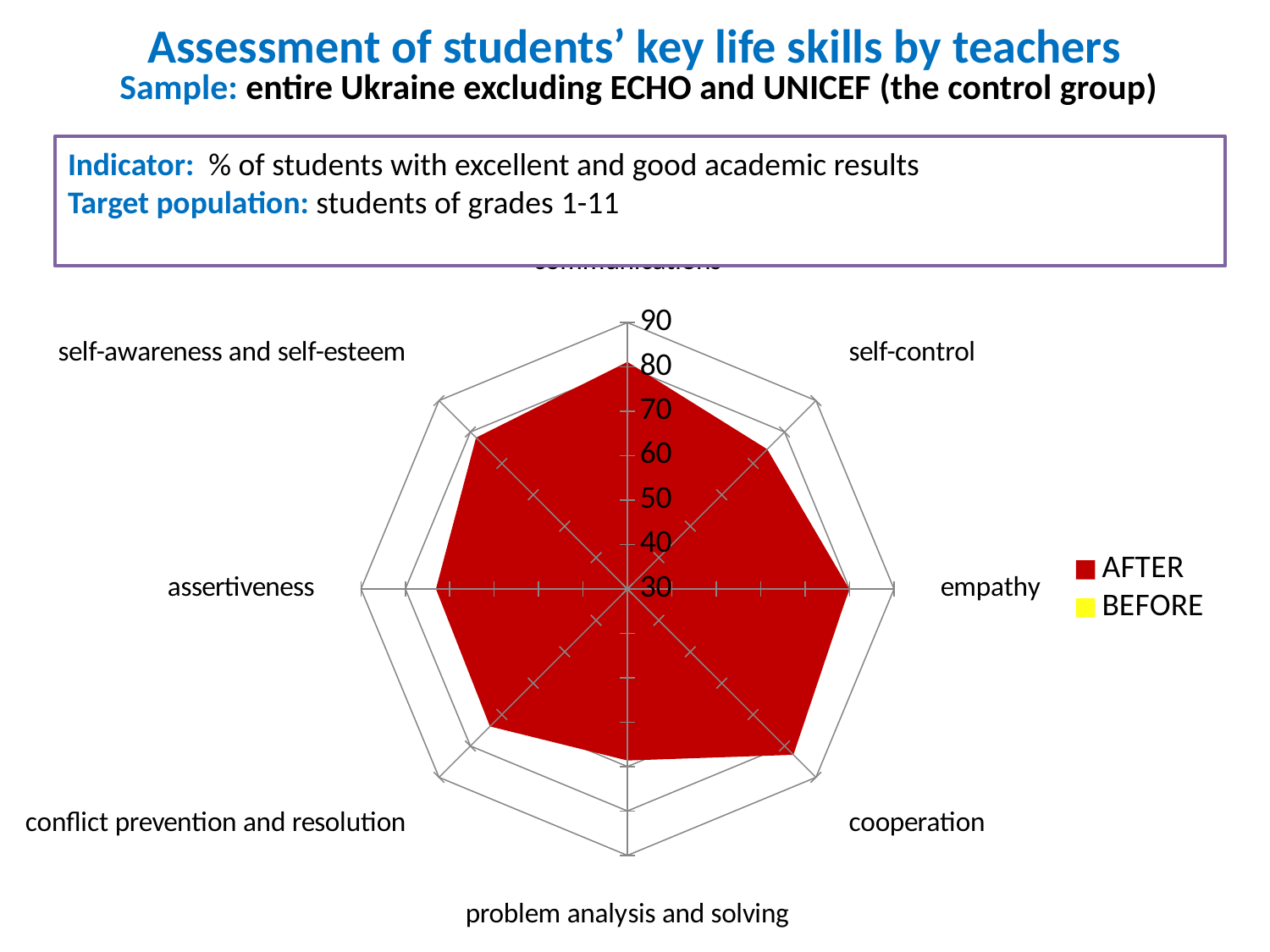
Is the AFTER value for self-control greater or less than 60? greater What are the two series named in the legend? AFTER and BEFORE How many skill categories are plotted on the radar chart? 8 Is the AFTER value for problem analysis and solving greater or less than 80? less Which has the larger AFTER value, self-awareness and self-esteem or conflict prevention and resolution? self-awareness and self-esteem Which has the larger AFTER value, empathy or problem analysis and solving? empathy Which series is shown in red on the chart? AFTER What kind of chart is shown on the slide? radar chart How many series does the legend list? 2 Is the AFTER value for empathy greater or less than 70? greater